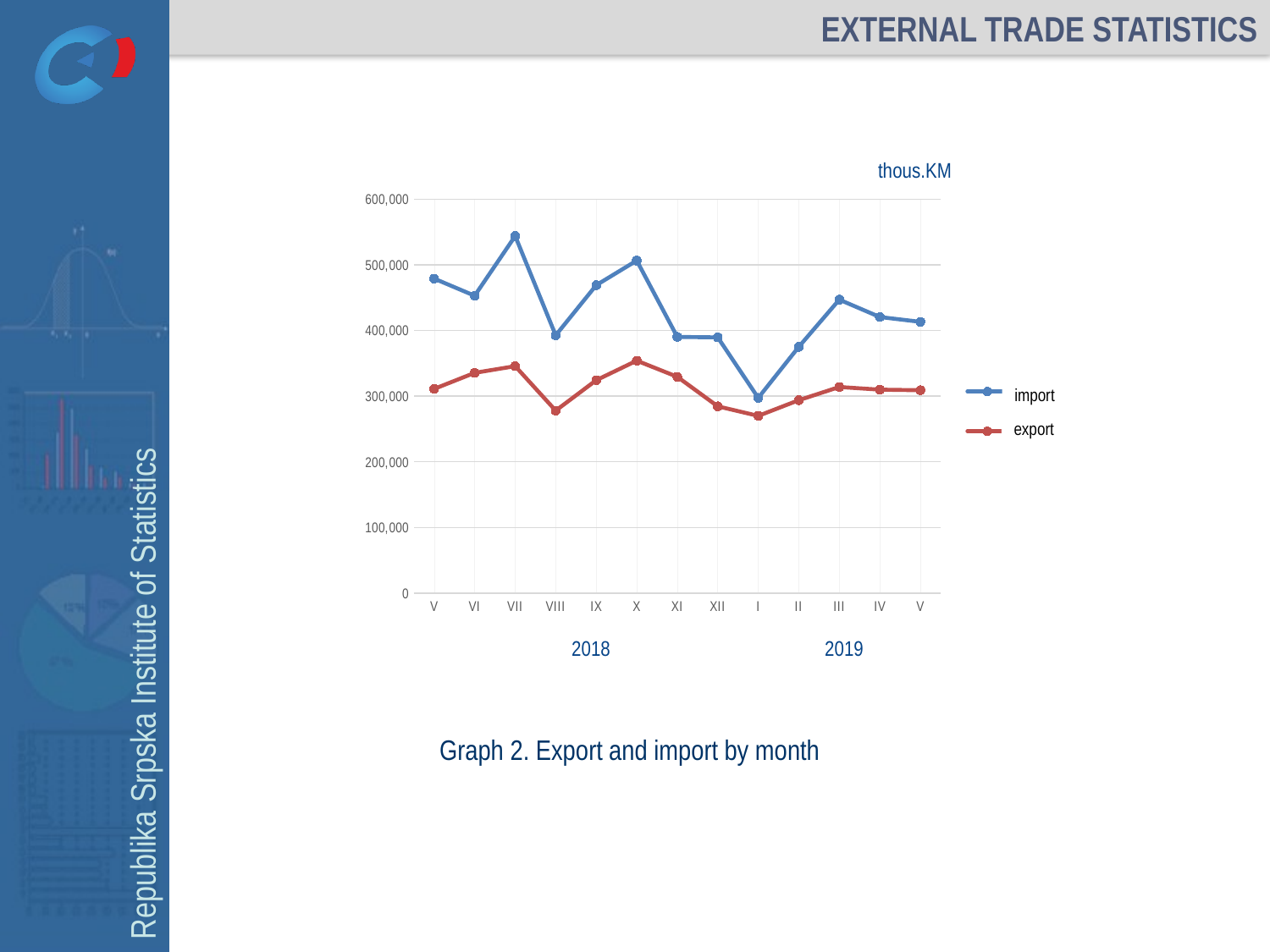
How many monthly points are plotted along the x axis of Graph 2? 13 In which month is the import value highest? VII 2018 How many series does the legend of Graph 2 list? 2 In which month is the import value lowest? I 2019 What kind of chart is Graph 2? line chart Is the export value for X 2018 greater or less than 300,000? greater Does the import line rise or fall from I 2019 to III 2019? rise Is the export value for I 2019 greater or less than 300,000? less Is the import value for VII 2018 greater or less than 500,000? greater Which is larger in X 2018, import or export? import What unit is shown above the chart? thous.KM Which is larger, the import value for VII 2018 or the import value for X 2018? VII 2018